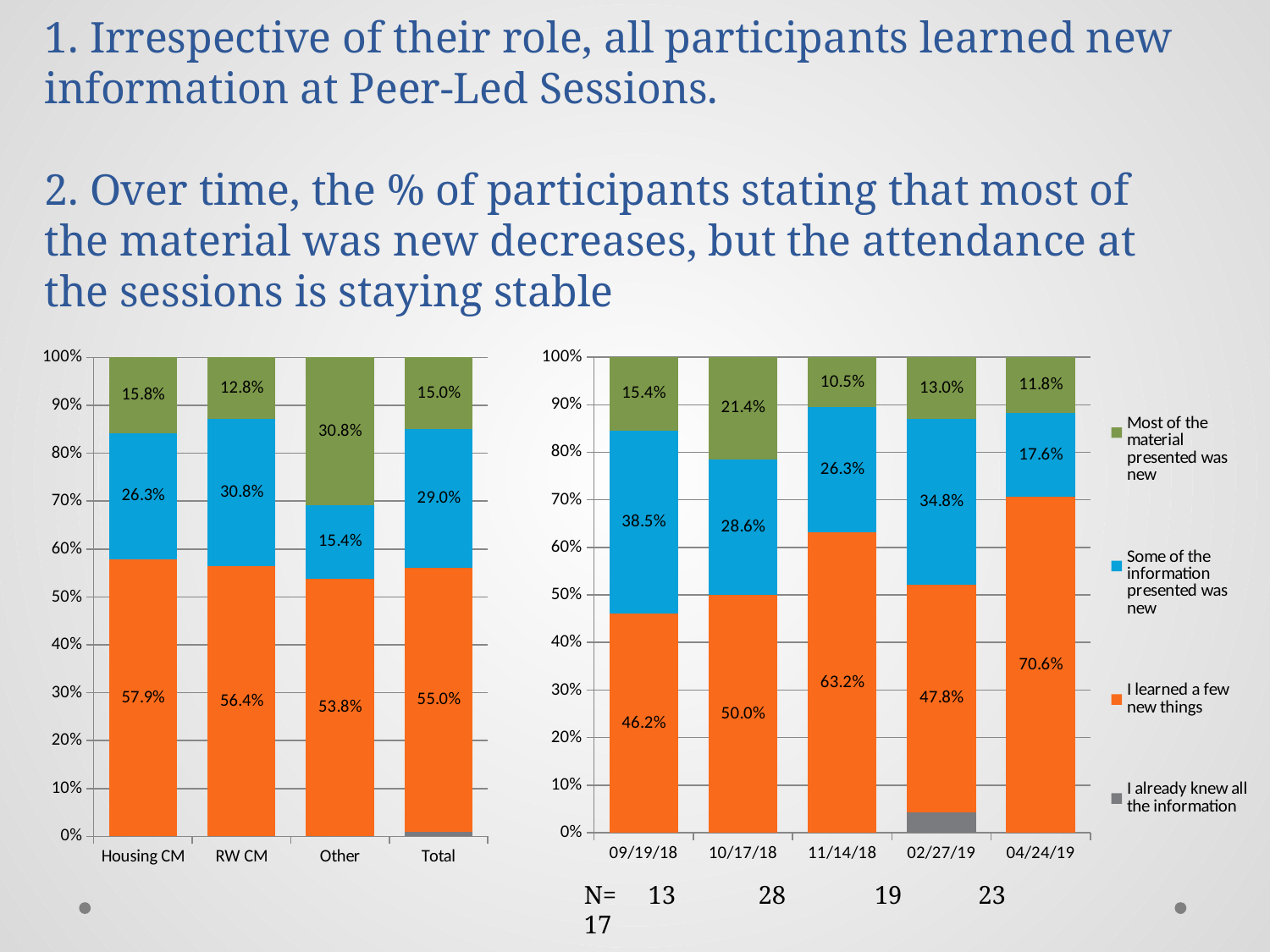
In the left chart, what percentage of Housing CM participants said "I learned a few new things"? 57.9% In the right chart, which date has the larger share for "Some of the information presented was new": 09/19/18 or 10/17/18? 09/19/18 How many dates are shown on the x axis of the right chart? 5 How many series does the legend of the right chart list? 4 How many categories are shown on the x axis of the left chart? 4 In the left chart, what is the difference between RW CM and Other for "Some of the information presented was new"? 15.4 percentage points In the right chart, how much higher is the "I learned a few new things" share on 04/24/19 than on 09/19/18? 24.4 percentage points In the right chart, which date has the lowest share for "Most of the material presented was new"? 11/14/18 What kind of chart is the right chart? Stacked bar chart In the right chart, which date has the highest share for "Most of the material presented was new"? 10/17/18 In the left chart, which category has the highest share for "Most of the material presented was new"? Other In the right chart, what percentage of participants on 04/24/19 said "I learned a few new things"? 70.6%